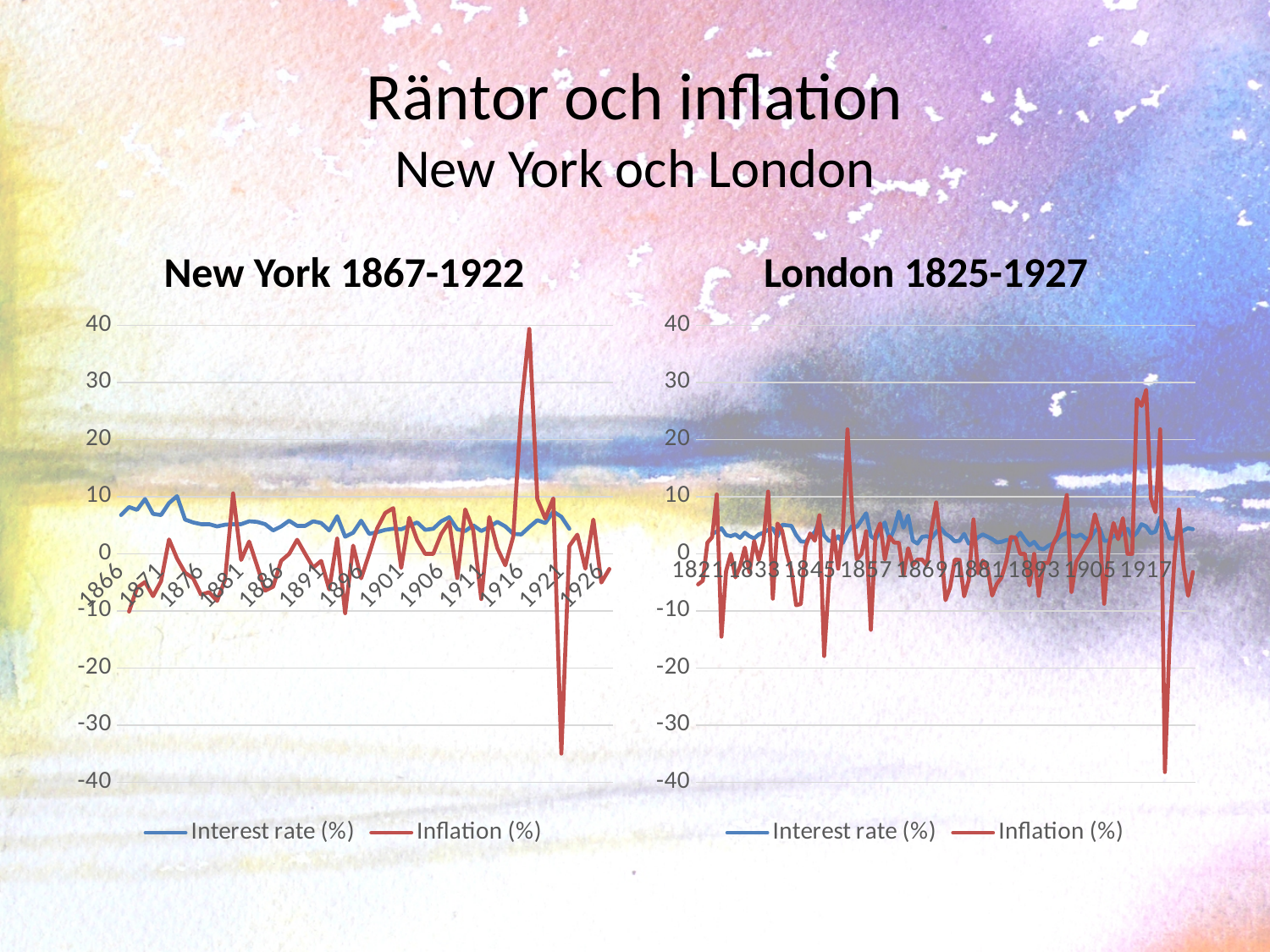
In the London 1825-1927 chart, which series is drawn in blue? Interest rate (%) In the London 1825-1927 chart, is the highest value of Interest rate (%) greater or less than 10? less In the New York 1867-1922 chart, which series reaches the higher peak value, Interest rate (%) or Inflation (%)? Inflation (%) What kind of chart is the New York 1867-1922 chart? line chart What kind of chart is the London 1825-1927 chart? line chart In the London 1825-1927 chart, is the lowest value of Inflation (%) greater or less than -30? less How many series does the legend of the London 1825-1927 chart list? 2 How many series does the legend of the New York 1867-1922 chart list? 2 In the New York 1867-1922 chart, is the lowest value of Inflation (%) greater or less than -30? less In the New York 1867-1922 chart, which series is drawn in red? Inflation (%) In the London 1825-1927 chart, which series reaches the lower minimum value, Interest rate (%) or Inflation (%)? Inflation (%)